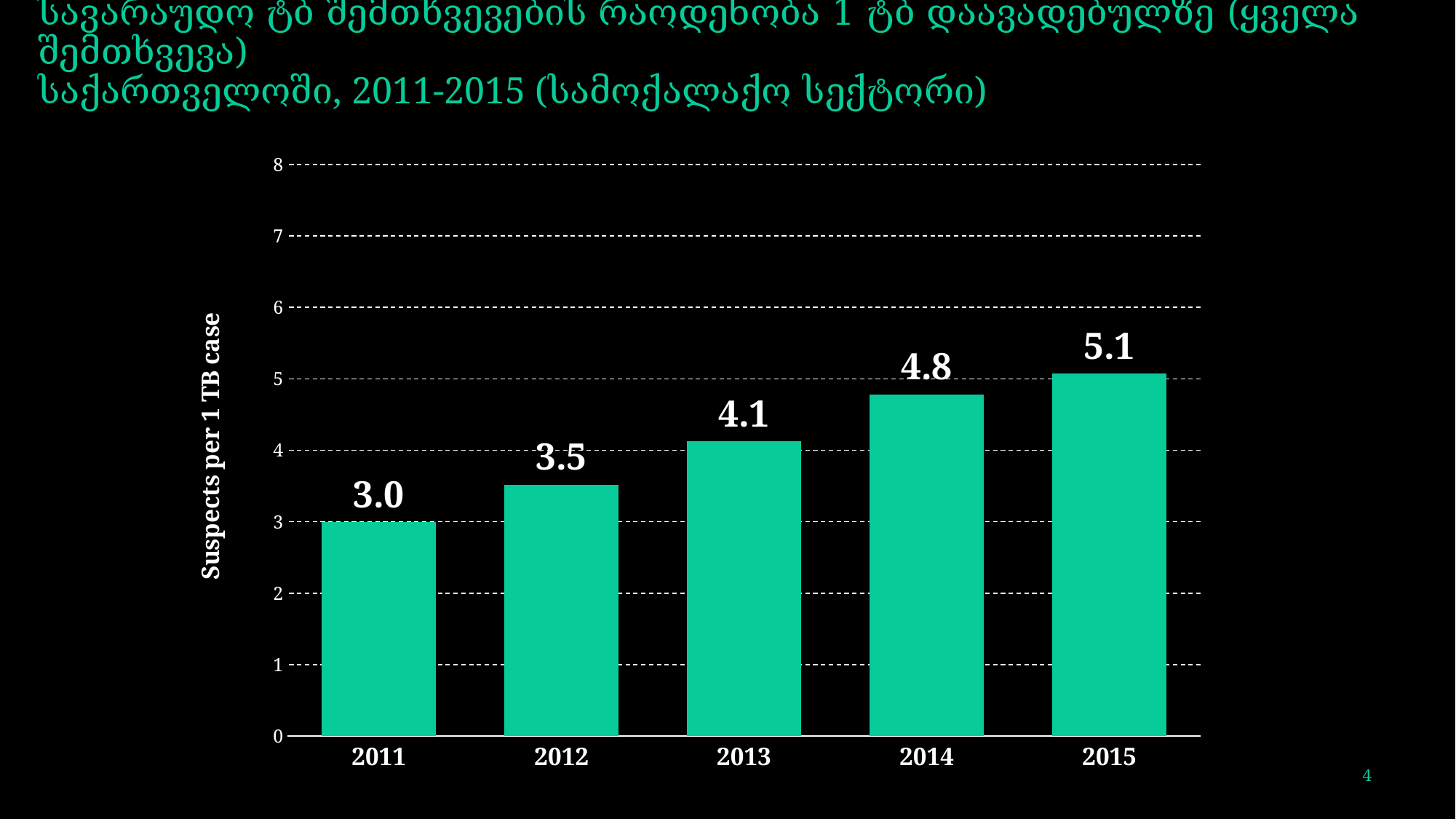
What is the difference between the values for 2015 and 2011? 2.1 What is the value for 2013? 4.1 Which year has the lowest value? 2011 Is the value for 2014 greater or less than 4? greater What kind of chart is shown on the slide? bar chart What is the difference between the values for 2014 and 2013? 0.7 Which year has the highest value? 2015 What is the value for 2015? 5.1 How many years are shown on the x axis? 5 Do the values rise or fall from 2011 to 2015? rise Which is larger, the value for 2012 or the value for 2014? 2014 What is the value for 2011? 3.0